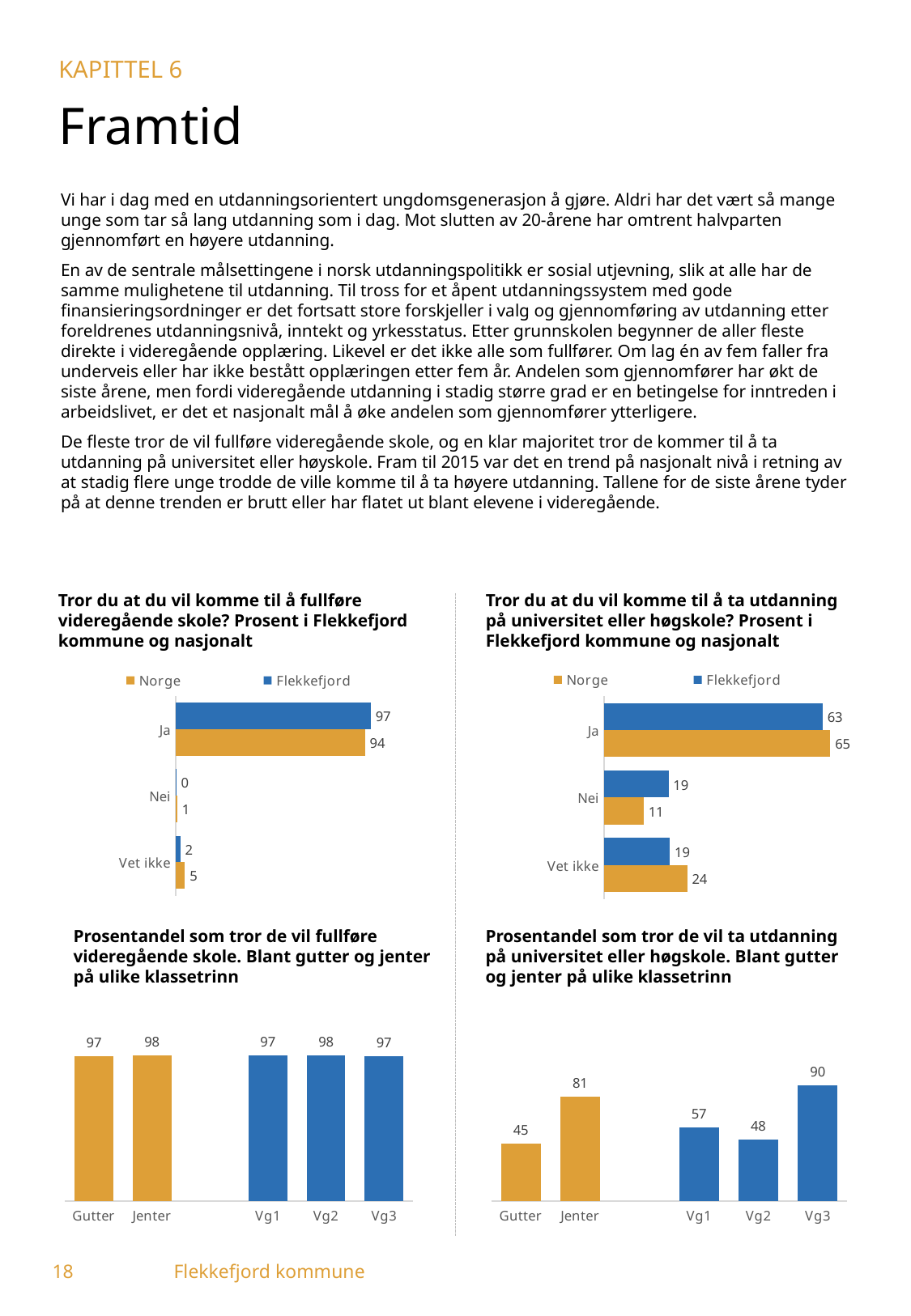
In the top-left chart ("Tror du at du vil komme til å fullføre videregående skole?"), what is the difference between the Flekkefjord and Norge values for "Ja"? 3 In the top-right chart ("Tror du at du vil komme til å ta utdanning på universitet eller høgskole?"), which is larger for "Nei": Flekkefjord or Norge? Flekkefjord In the bottom-right chart ("Prosentandel som tror de vil ta utdanning på universitet eller høgskole"), what is the difference between the values for Jenter and Gutter? 36 In the top-right chart ("Tror du at du vil komme til å ta utdanning på universitet eller høgskole?"), how many series does the legend list? 2 In the top-right chart ("Tror du at du vil komme til å ta utdanning på universitet eller høgskole?"), what is the value for Norge for "Vet ikke"? 24 In the top-left chart ("Tror du at du vil komme til å fullføre videregående skole?"), what is the value for Flekkefjord for "Ja"? 97 In the bottom-right chart ("Prosentandel som tror de vil ta utdanning på universitet eller høgskole"), which category has the highest value? Vg3 In the top-left chart ("Tror du at du vil komme til å fullføre videregående skole?"), what is the value for Norge for "Vet ikke"? 5 In the top-right chart ("Tror du at du vil komme til å ta utdanning på universitet eller høgskole?"), what is the difference between the Norge and Flekkefjord values for "Nei"? 8 In the bottom-right chart ("Prosentandel som tror de vil ta utdanning på universitet eller høgskole"), which category has the lowest value? Gutter In the bottom-left chart ("Prosentandel som tror de vil fullføre videregående skole"), what is the value for Jenter? 98 In the bottom-left chart ("Prosentandel som tror de vil fullføre videregående skole"), how many categories are shown on the x axis? 5